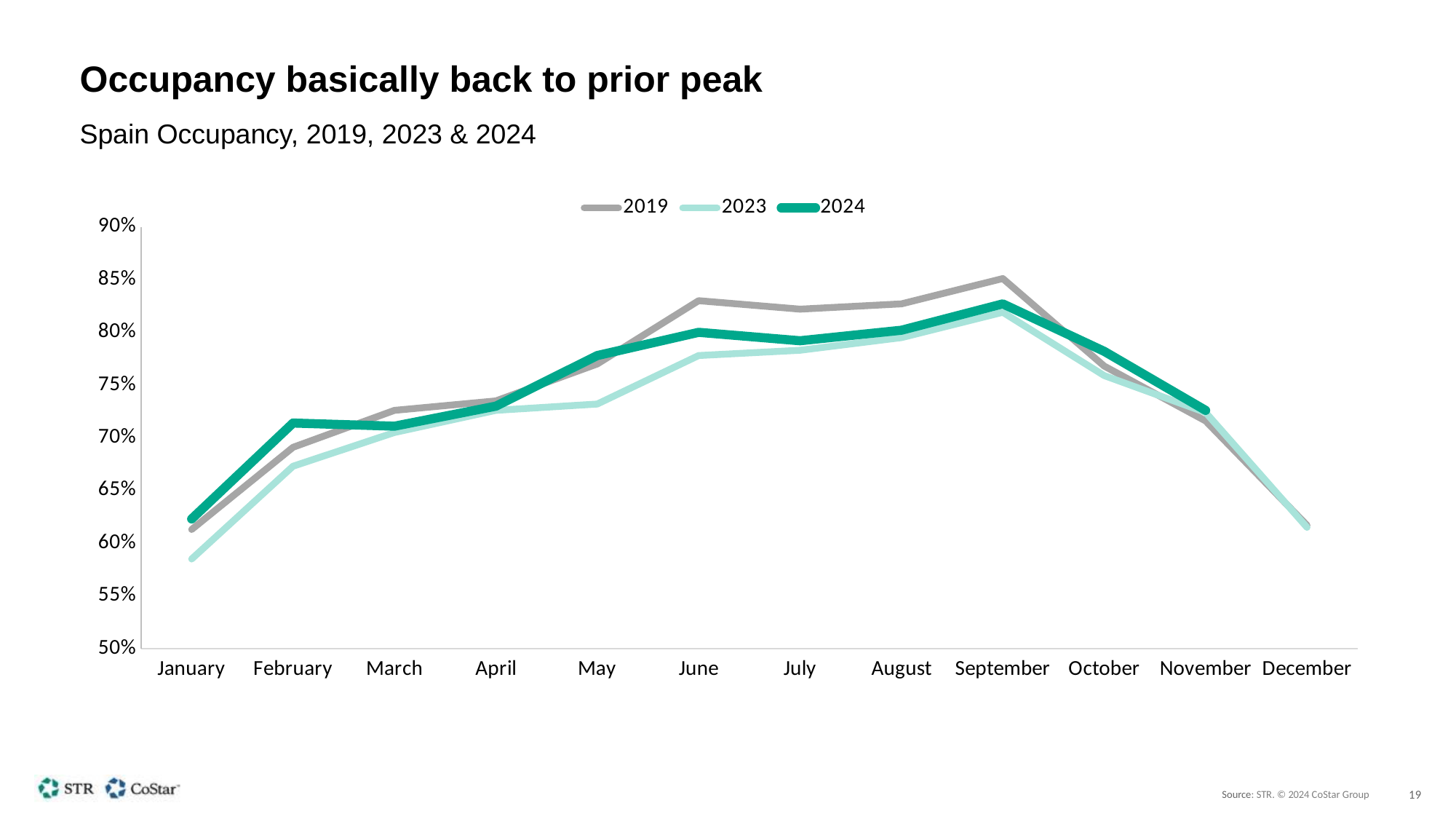
Is the value for 2019 in June greater or less than 80%? greater Is the value for 2024 in February greater or less than 70%? greater In which month does the 2023 series have its lowest value? January In which month does the 2024 series reach its highest value? September In May, which series has the higher value, 2023 or 2024? 2024 Does the 2019 series rise or fall from January to September? rise What kind of chart is shown on the slide? Line chart In June, which series has the higher value, 2019 or 2023? 2019 How many series does the legend list? 3 In which month does the 2019 series reach its highest value? September Is the value for 2023 in January greater or less than 60%? less How many months are shown on the x axis? 12